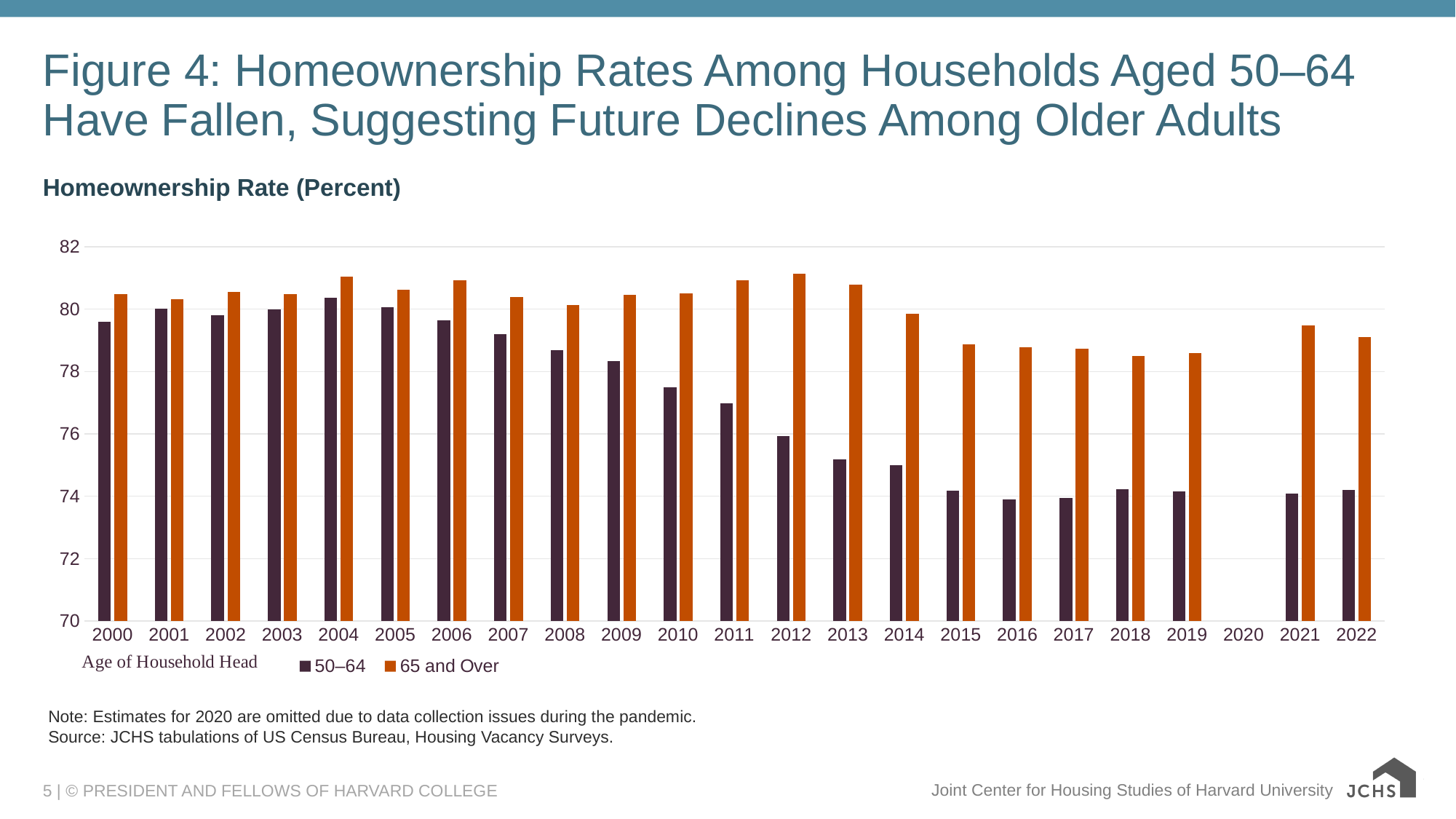
How many series does the legend list? 2 Is the value for the 50–64 series in 2022 greater or less than 76? less Is the value for the 50–64 series in 2010 greater or less than 78? less For the 50–64 series, is the value in 2004 larger or smaller than the value in 2016? larger Is the value for the 65 and Over series in 2018 greater or less than 80? less Which year on the x axis has no bars plotted? 2020 Which series does the orange bar represent? 65 and Over In 2000, which series has the larger value, 50–64 or 65 and Over? 65 and Over Does the 50–64 series generally rise or fall from 2000 to 2022? fall What kind of chart is shown on the slide? bar chart